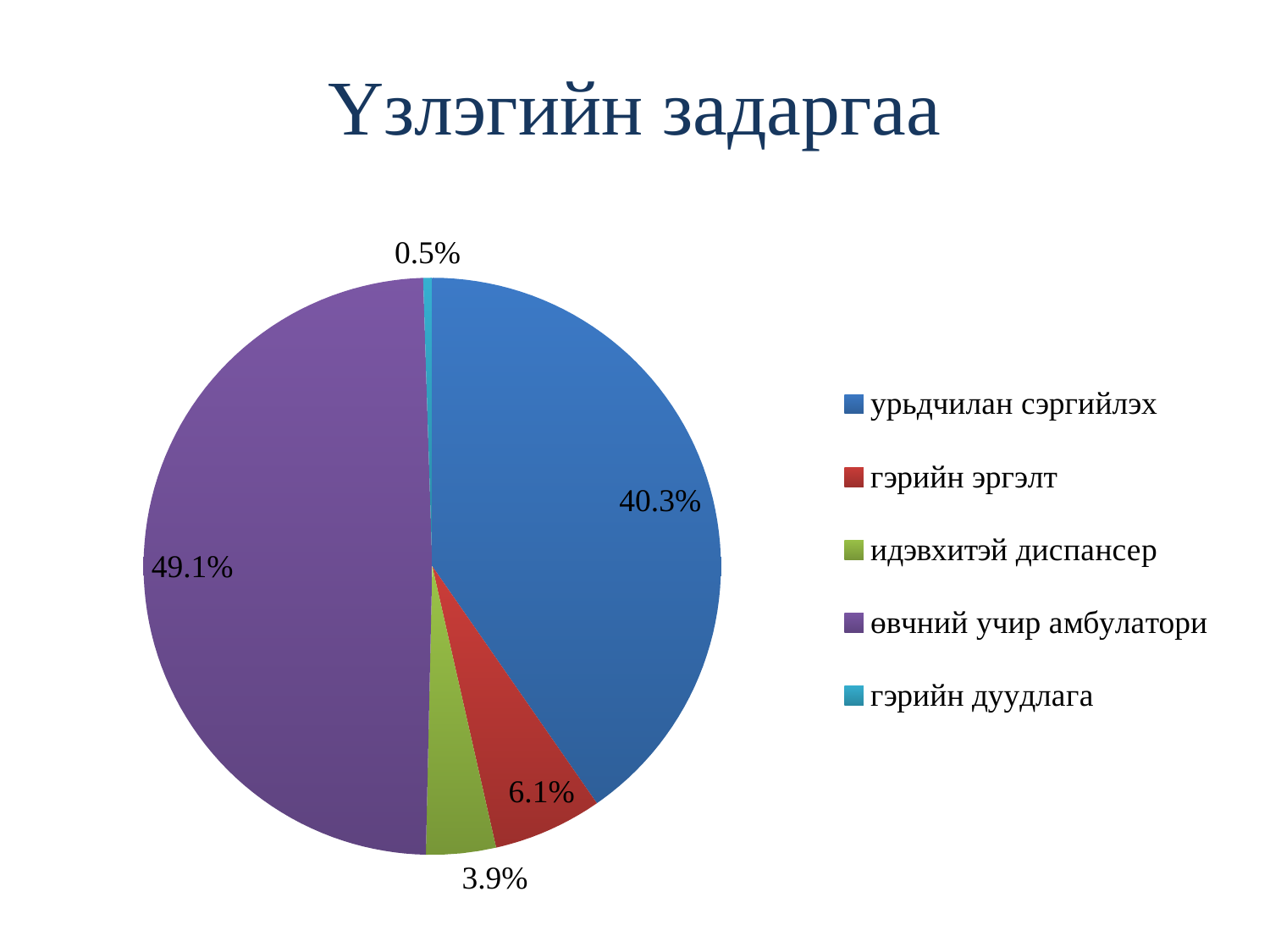
What is the value for 'идэвхитэй диспансер'? 3.9% What type of chart is shown on the slide? pie chart What share of the pie does 'өвчний учир амбулатори' have? 49.1% What is the title of the chart? Үзлэгийн задаргаа What is the difference between the shares of 'өвчний учир амбулатори' and 'урьдчилан сэргийлэх'? 8.8% Which is larger, 'гэрийн эргэлт' or 'идэвхитэй диспансер'? гэрийн эргэлт How many categories does the legend list? 5 What share of the pie does 'урьдчилан сэргийлэх' have? 40.3% Which category has the largest share of the pie? өвчний учир амбулатори Which category has the smallest share of the pie? гэрийн дуудлага What is the value for 'гэрийн дуудлага'? 0.5% What is the value for 'гэрийн эргэлт'? 6.1%